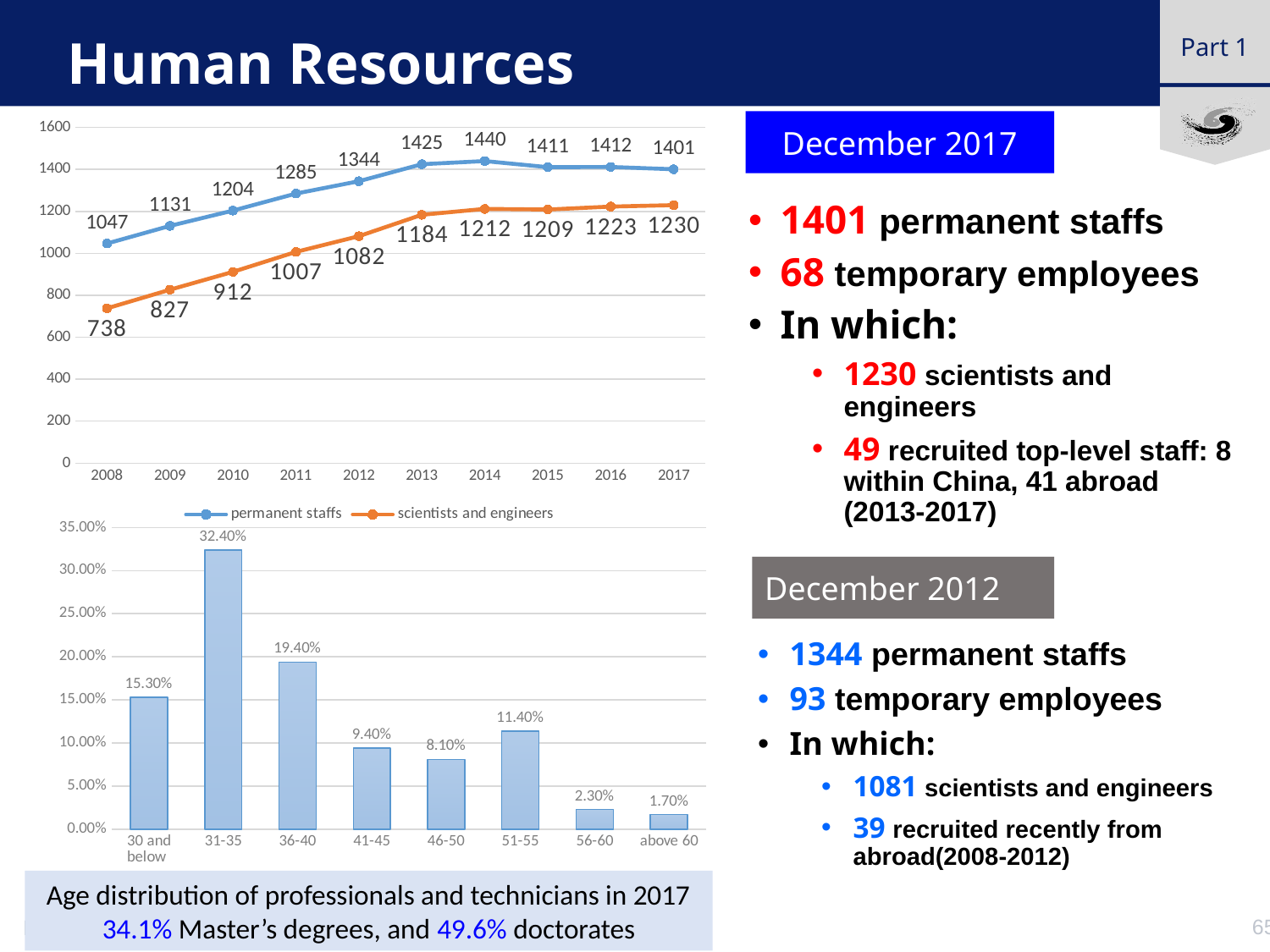
In the bottom bar chart, which is larger, the value for 41-45 or the value for 51-55? 51-55 In the top line chart, what is the value for permanent staffs in 2014? 1440 In the top line chart, which year has the highest value for permanent staffs? 2014 In the bottom bar chart, which age group has the lowest value? above 60 In the bottom bar chart, how many age groups are shown? 8 In the bottom bar chart, what is the value for the 36-40 age group? 19.40% In the top line chart, which year has the lowest value for scientists and engineers? 2008 In the top line chart, what is the difference between permanent staffs and scientists and engineers in 2017? 171 In the top line chart, does the scientists and engineers series generally rise or fall from 2008 to 2017? rise In the top line chart, what is the value for scientists and engineers in 2012? 1082 In the bottom bar chart, which age group has the highest value? 31-35 In the top line chart, how many series does the legend list? 2